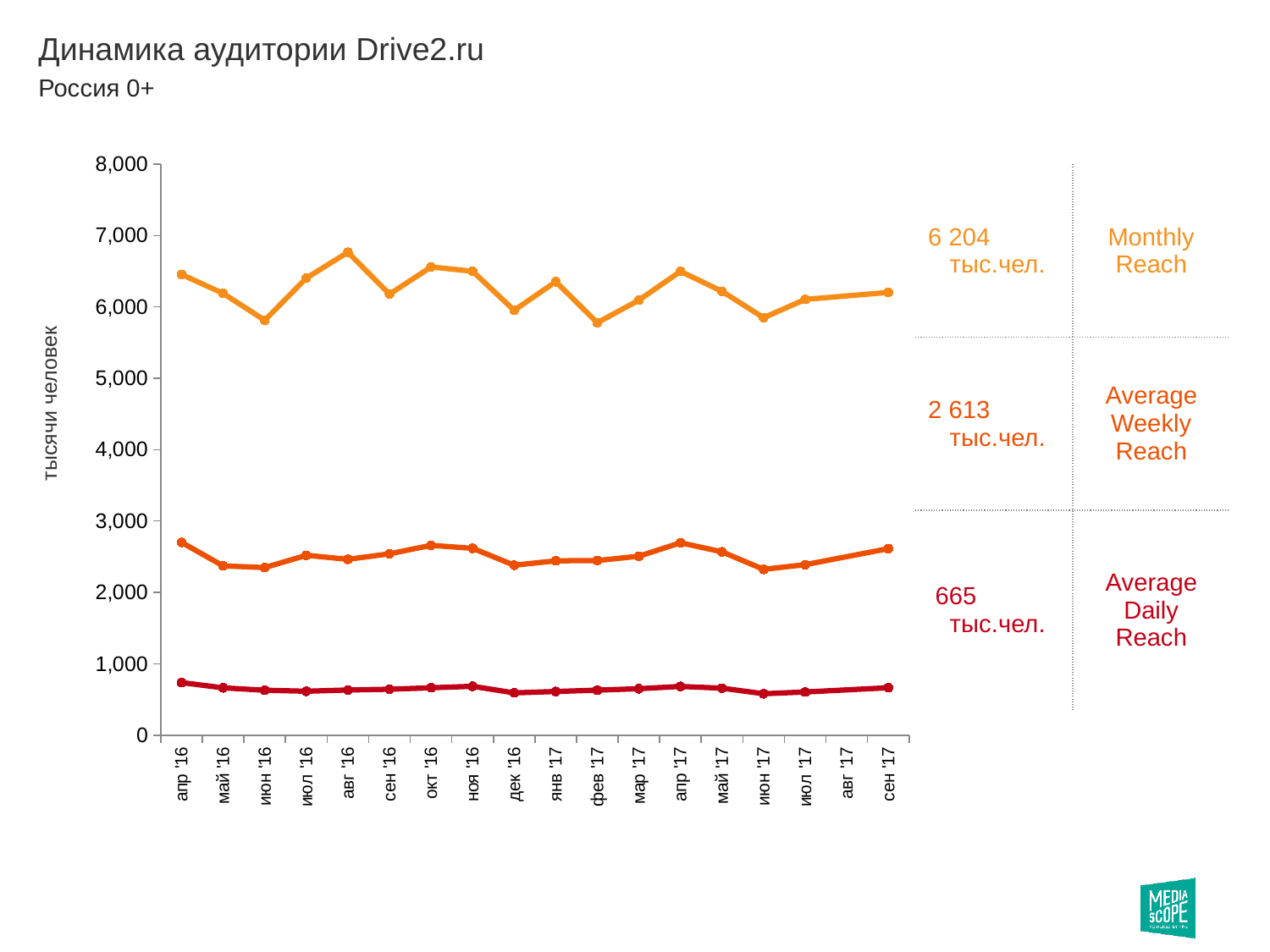
In which month does the Monthly Reach line reach its highest point? авг '16 How many months are shown along the x axis of the chart? 18 What is the Average Weekly Reach value shown for сен '17? 2 613 тыс.чел. Which is larger: the Average Weekly Reach in апр '16 or in июн '17? апр '16 Is the Monthly Reach value for июн '16 greater or less than 6,000? less Is the Average Daily Reach value for апр '16 greater or less than 1,000? less What kind of chart is shown on the slide? line chart Is the Monthly Reach value for авг '16 greater or less than 6,000? greater How many data series (lines) are plotted on the chart? 3 What is the label on the vertical axis of the chart? тысячи человек What is the Average Daily Reach value shown for сен '17? 665 тыс.чел. What is the Monthly Reach value shown for сен '17? 6 204 тыс.чел.